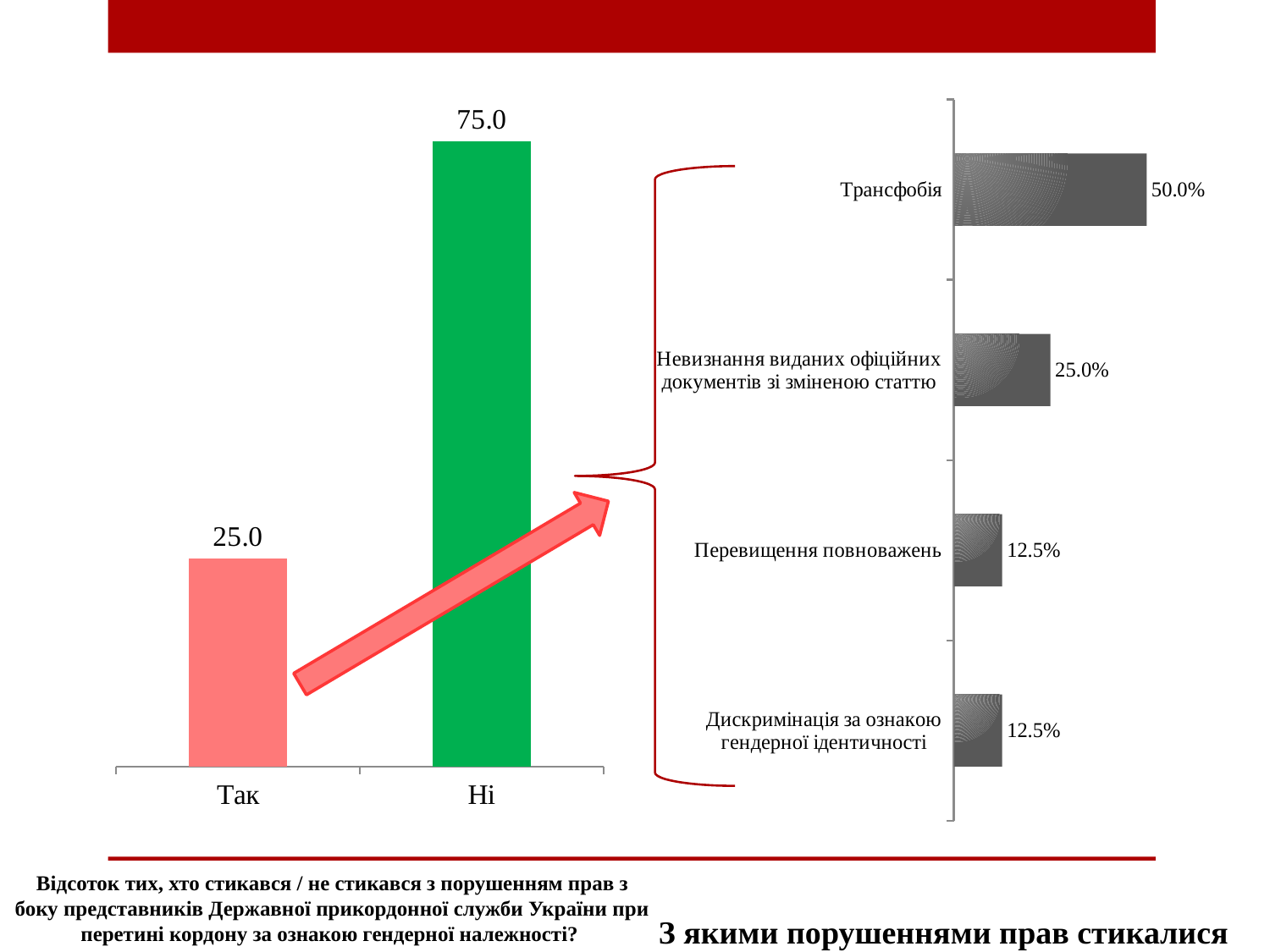
In the left chart, which category has the higher value, "Так" or "Ні"? Ні In the right chart, what is the value for "Трансфобія"? 50.0% In the right chart, what is the difference between the values for "Трансфобія" and "Дискримінація за ознакою гендерної ідентичності"? 37.5% In the left chart, what is the difference between the values for "Ні" and "Так"? 50.0 In the left chart, how many categories are shown? 2 What kind of chart is the left chart? Bar chart In the right chart, which category has the highest value? Трансфобія In the right chart, how many categories are shown? 4 In the right chart, what is the value for "Невизнання виданих офіційних документів зі зміненою статтю"? 25.0% In the left chart, what is the value for "Так"? 25.0 In the right chart, what is the value for "Перевищення повноважень"? 12.5% In the left chart, what is the value for "Ні"? 75.0